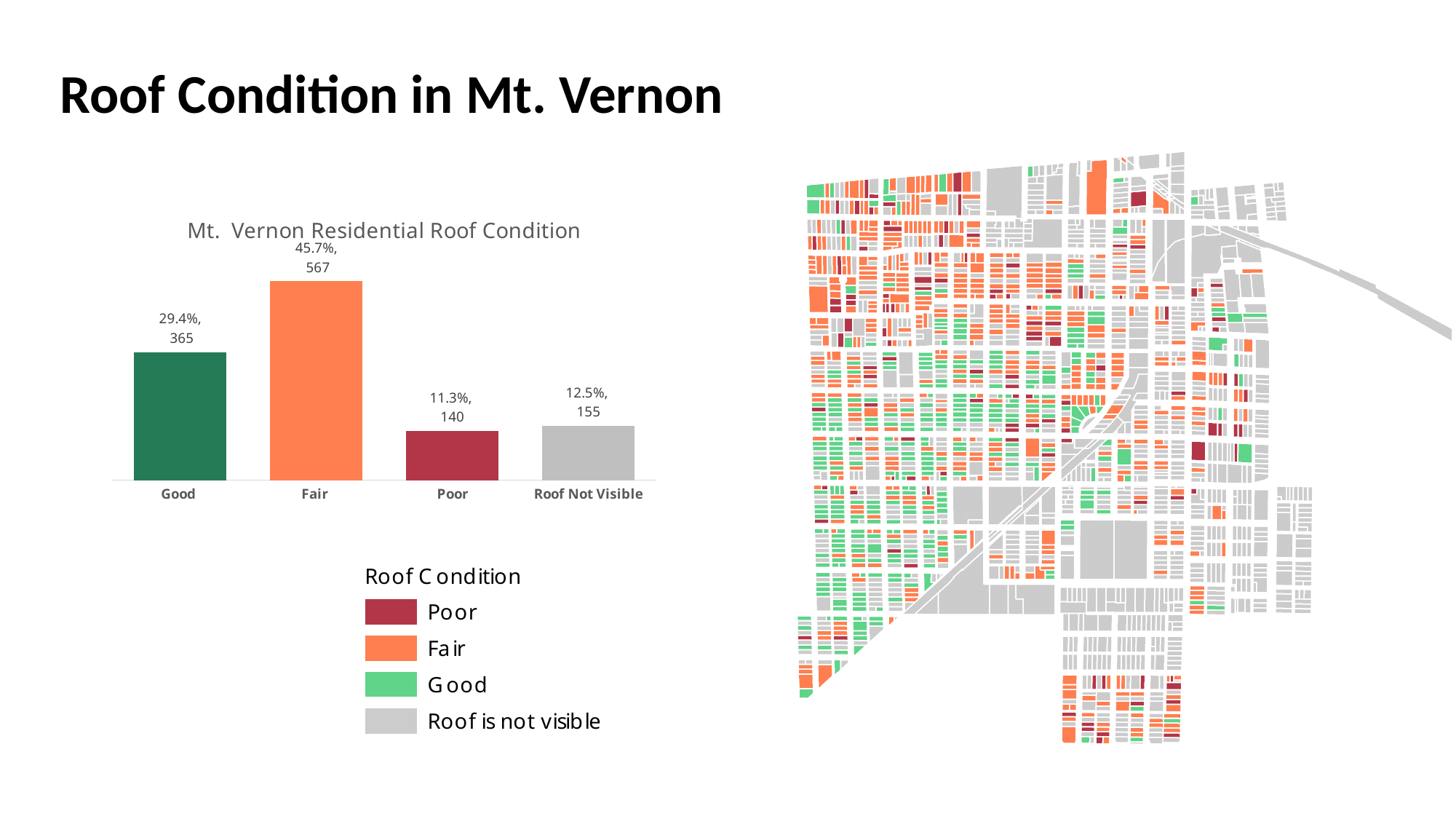
What is the title of the chart on the left of the slide? Mt. Vernon Residential Roof Condition What is the difference in count between Roof Not Visible and Poor? 15 What percentage is shown for the Roof Not Visible category? 12.5% What is the count for the Fair category in the Mt. Vernon Residential Roof Condition chart? 567 Which roof condition category has the lowest count? Poor What type of chart is the Mt. Vernon Residential Roof Condition chart? Bar chart What percentage of roofs are in Good condition according to the chart? 29.4% What is the count for the Poor category? 140 Which roof condition category has the highest count? Fair What is the difference in count between the Fair and Good categories? 202 Which has a larger count, Good or Roof Not Visible? Good How many categories are shown in the bar chart? 4